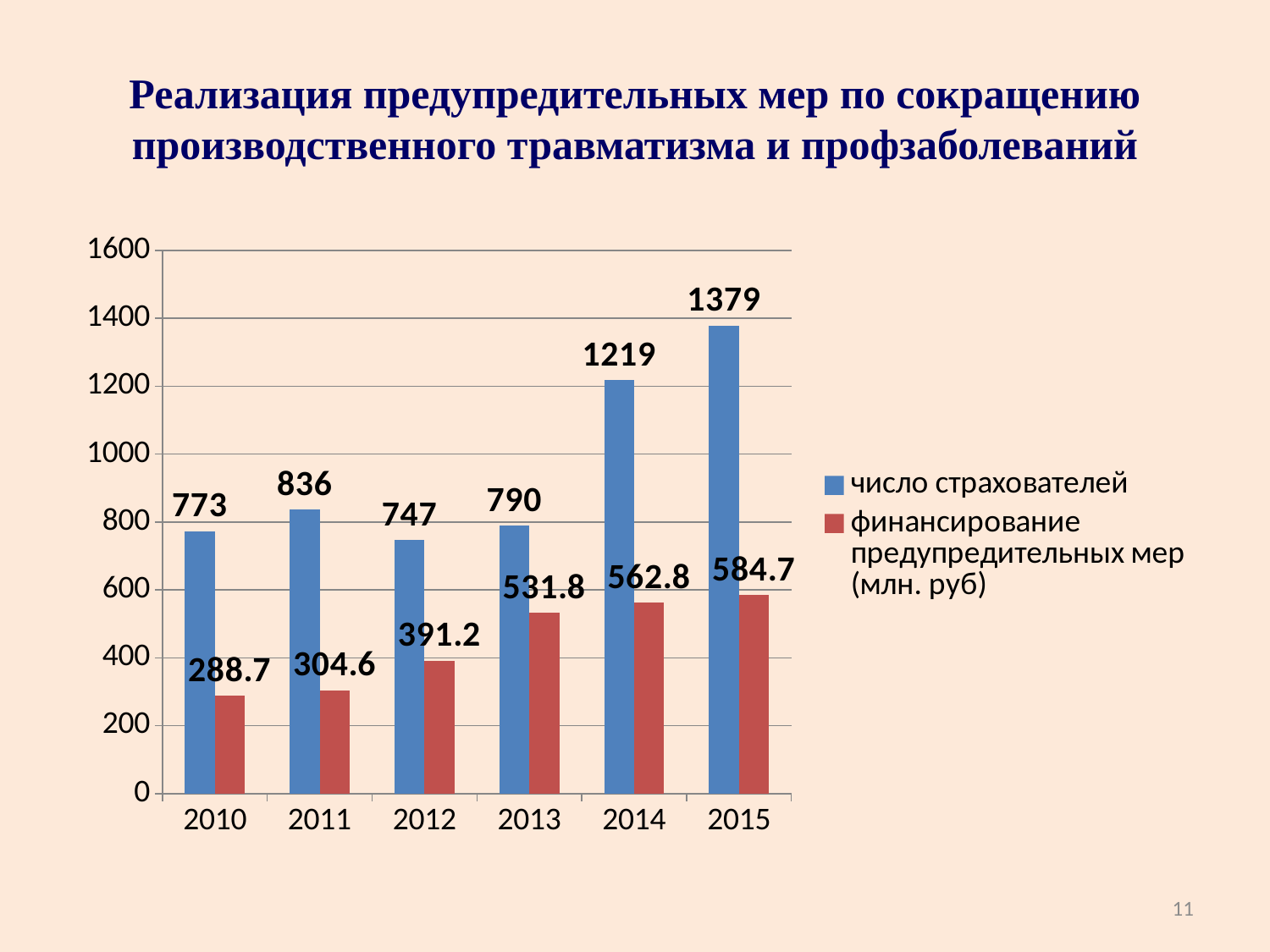
What is the value of финансирование предупредительных мер (млн. руб) for 2012? 391.2 Which year has the highest value for число страхователей? 2015 What is the difference between число страхователей in 2015 and in 2014? 160 Which year has the lowest value for финансирование предупредительных мер (млн. руб)? 2010 Which is larger: число страхователей in 2011 or in 2012? 2011 What kind of chart is shown on the slide? bar chart Does финансирование предупредительных мер rise or fall from 2010 to 2015? rise How many years are shown on the x axis? 6 How many series does the legend list? 2 What colour are the bars for число страхователей? blue What is the value of число страхователей for 2013? 790 What is the difference between финансирование предупредительных мер in 2015 and in 2010? 296.0